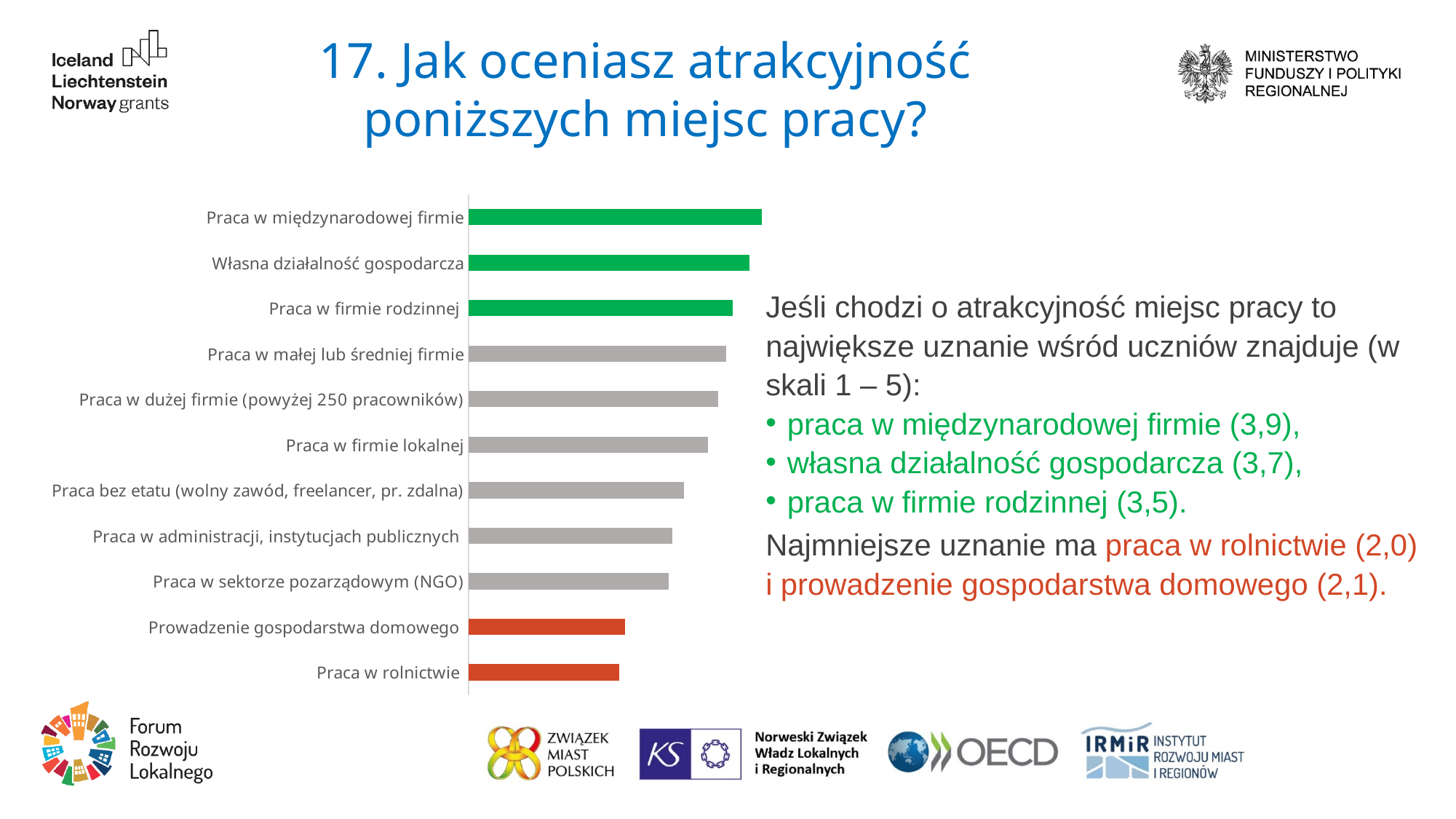
What is the rating for 'Praca w międzynarodowej firmie'? 3,9 Which has a larger value: 'Praca w firmie lokalnej' or 'Prowadzenie gospodarstwa domowego'? Praca w firmie lokalnej Which has a larger value: 'Praca w małej lub średniej firmie' or 'Praca w sektorze pozarządowym (NGO)'? Praca w małej lub średniej firmie How many bars in the chart are coloured green? 3 How many categories (job types) are plotted in the chart? 11 What is the rating for 'Praca w firmie rodzinnej'? 3,5 Which category has the lowest value in the chart? Praca w rolnictwie What is the rating for 'Prowadzenie gospodarstwa domowego'? 2,1 What kind of chart is shown on the slide? bar chart What is the rating for 'Własna działalność gospodarcza'? 3,7 What is the difference between the ratings for 'Praca w międzynarodowej firmie' and 'Praca w rolnictwie'? 1,9 Which category has the highest value in the chart? Praca w międzynarodowej firmie